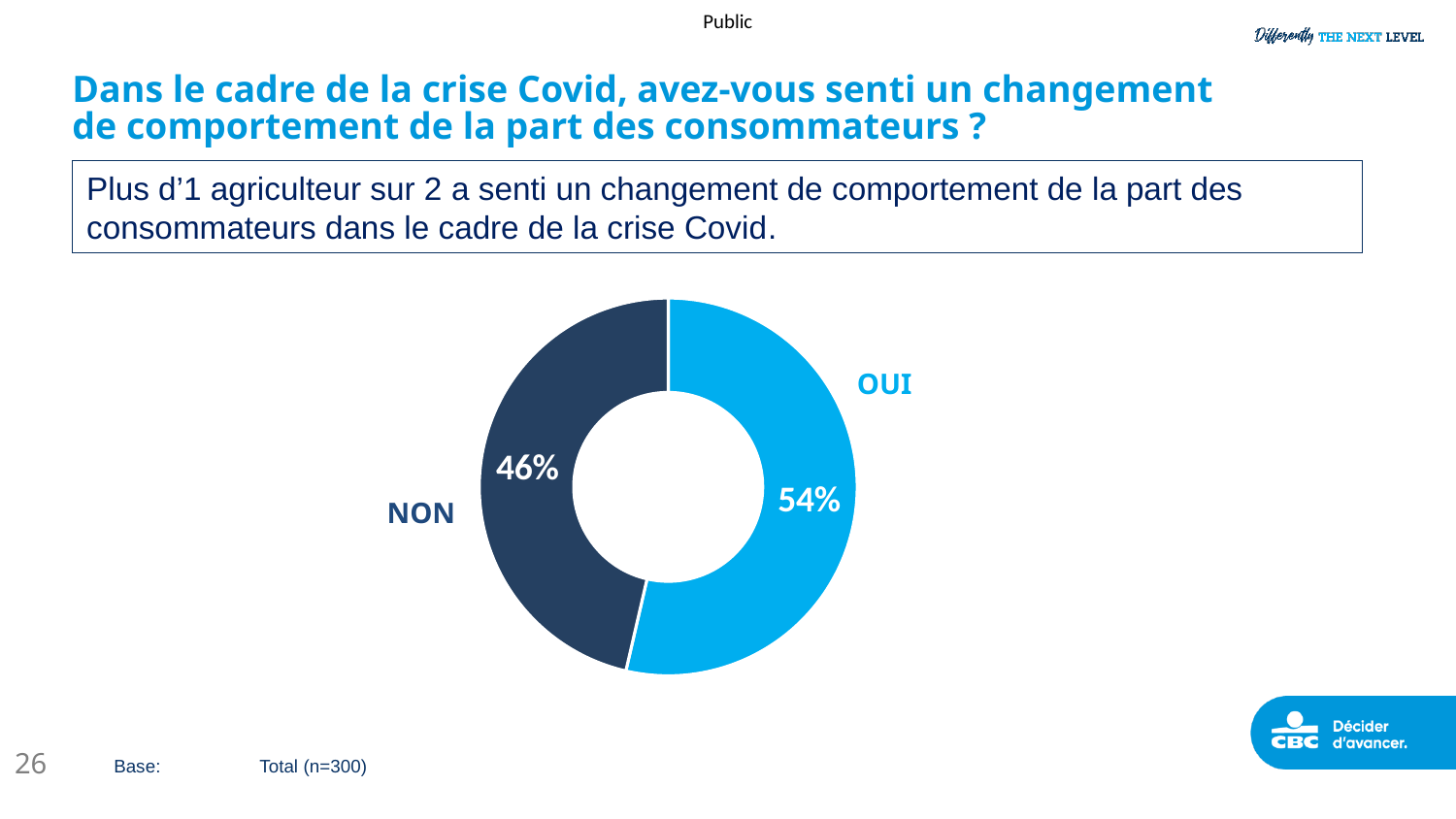
What colour is the OUI slice of the chart? Light blue Which category has the smallest share of the chart? NON What is the base (sample size) stated for the chart? Total (n=300) What percentage of respondents answered NON? 46% Which category has the largest share of the chart? OUI What kind of chart is shown on the slide? Pie chart (donut) Which response has the larger share, OUI or NON? OUI What is the difference in percentage points between the OUI and NON shares? 8 Is the share for OUI greater or less than 50%? greater What is the total of the two shares shown in the chart? 100% What percentage of respondents answered OUI? 54% How many categories are shown in the chart? 2